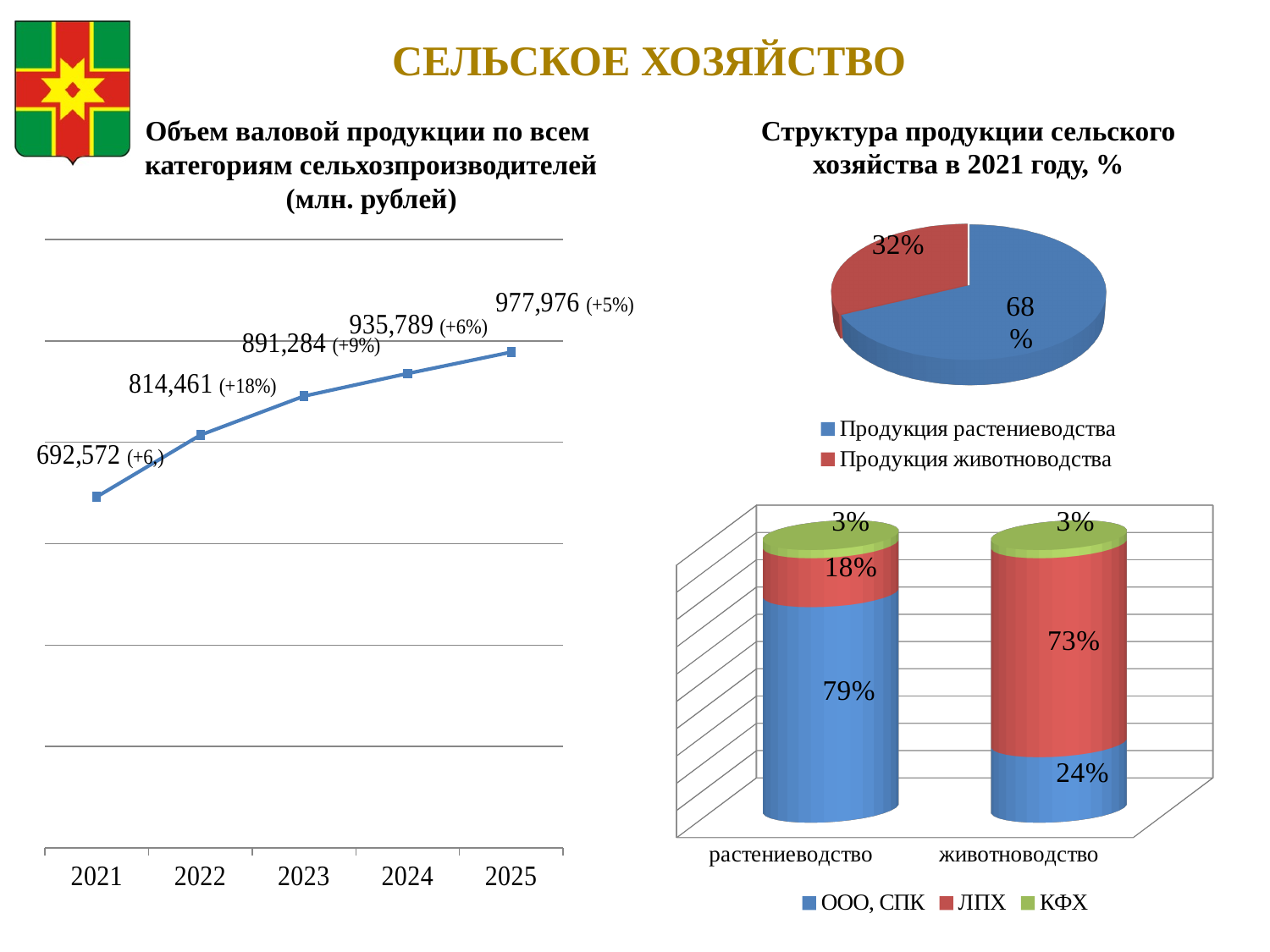
How many years are plotted in the line chart 'Объем валовой продукции по всем категориям сельхозпроизводителей (млн. рублей)'? 5 In the line chart 'Объем валовой продукции по всем категориям сельхозпроизводителей (млн. рублей)', what is the value for 2023? 891,284 In the line chart 'Объем валовой продукции по всем категориям сельхозпроизводителей (млн. рублей)', do the values rise or fall from 2021 to 2025? rise In the line chart 'Объем валовой продукции по всем категориям сельхозпроизводителей (млн. рублей)', which year has the lowest value? 2021 How many series does the legend of the stacked bar chart at the bottom right list? 3 In the pie chart 'Структура продукции сельского хозяйства в 2021 году, %', which category has the largest slice? Продукция растениеводства In the line chart 'Объем валовой продукции по всем категориям сельхозпроизводителей (млн. рублей)', what is the difference between the 2022 and 2021 values? 121,889 In the stacked bar chart at the bottom right, what is the value of 'ООО, СПК' for 'растениеводство'? 79% In the stacked bar chart at the bottom right, which is larger: 'ООО, СПК' for 'растениеводство' or 'ООО, СПК' for 'животноводство'? растениеводство In the stacked bar chart at the bottom right, what is the value of 'ЛПХ' for 'животноводство'? 73% In the pie chart 'Структура продукции сельского хозяйства в 2021 году, %', what share does 'Продукция животноводства' have? 32% In the line chart 'Объем валовой продукции по всем категориям сельхозпроизводителей (млн. рублей)', what is the value for 2025? 977,976